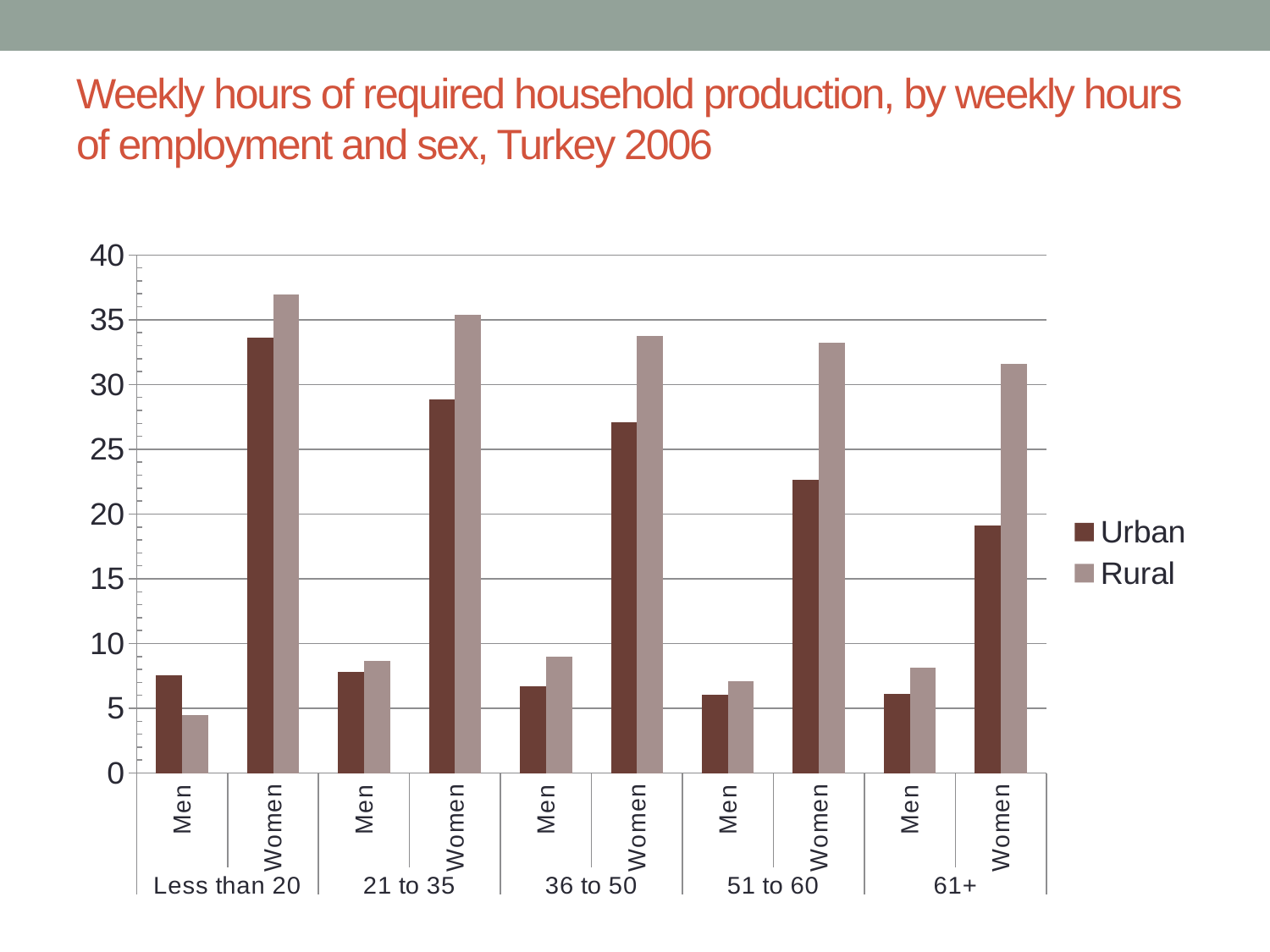
How many series does the legend list? 2 Is the Rural value for Women in the 61+ group greater or less than 30? greater Do the Urban values for Women rise or fall as weekly hours of employment increase from Less than 20 to 61+? Fall What are the two series named in the legend? Urban and Rural Is the Urban value for Men in the 21 to 35 group greater or less than 10? less Is the Urban value for Women in the Less than 20 group greater or less than 30? greater For Men in the Less than 20 group, which is larger, the Urban or the Rural value? Urban How many weekly-hours-of-employment groups are shown on the x axis? 5 What kind of chart is shown on the slide? Bar chart Which group has the highest Rural bar? Women, Less than 20 Which bar is the lowest on the whole chart? Rural, Men, Less than 20